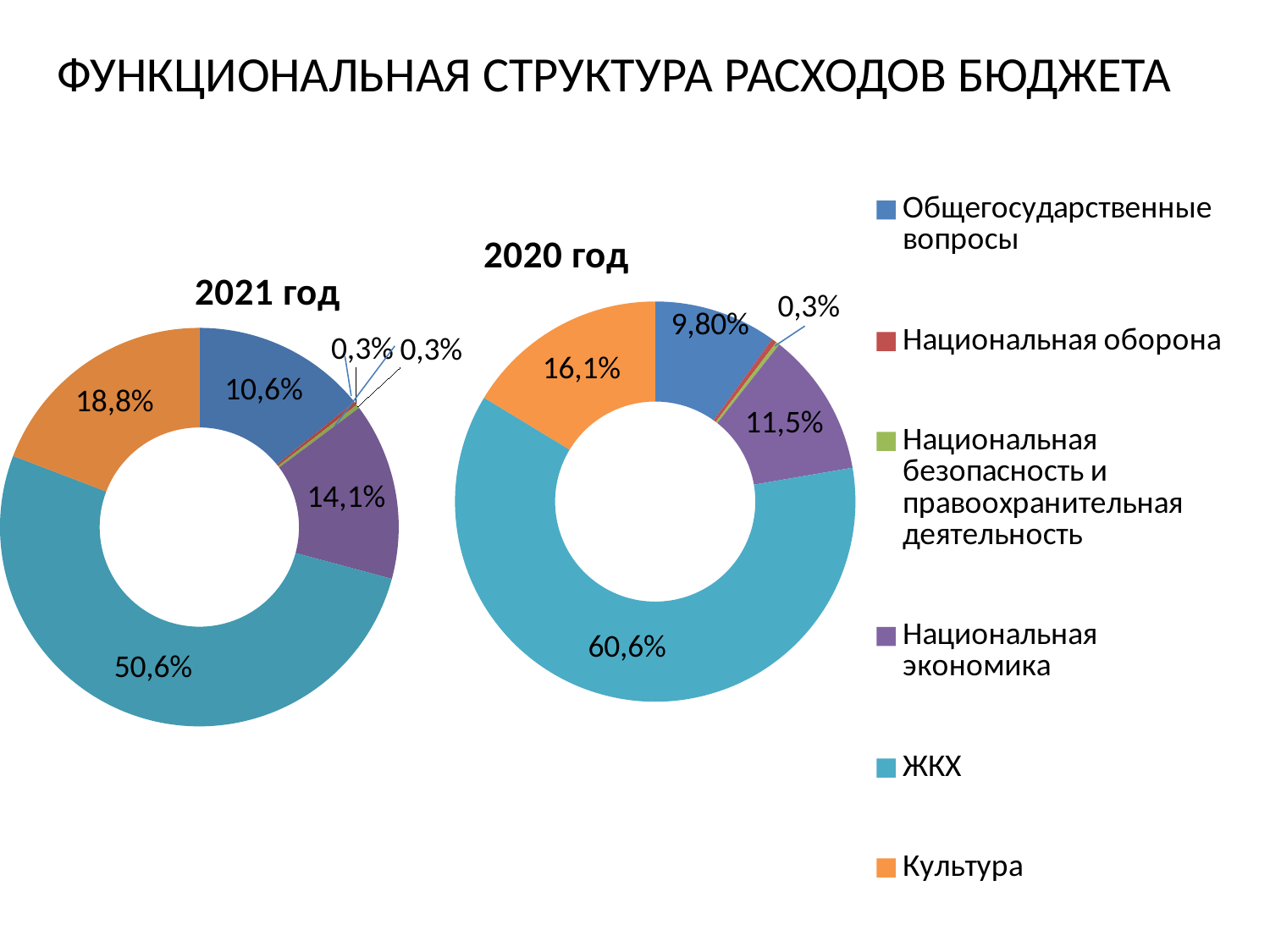
Which is larger: the share of Культура in the "2021 год" chart or in the "2020 год" chart? 2021 год In the "2020 год" chart, what is the value for Общегосударственные вопросы? 9,80% What kind of chart is the "2021 год" chart? Doughnut (pie) chart What colour represents ЖКХ in the legend? Teal (light blue) In the "2021 год" chart, what is the value for Культура? 18,8% How many series does the legend list? 6 In the "2020 год" chart, which category has the largest share? ЖКХ In the "2020 год" chart, what is the value for Национальная экономика? 11,5% In the "2021 год" chart, what is the difference between the shares of Культура and Национальная экономика? 4,7% In the "2020 год" chart, what share does ЖКХ have? 60,6% In the "2021 год" chart, what share does ЖКХ have? 50,6% In the "2021 год" chart, which category has the largest share? ЖКХ